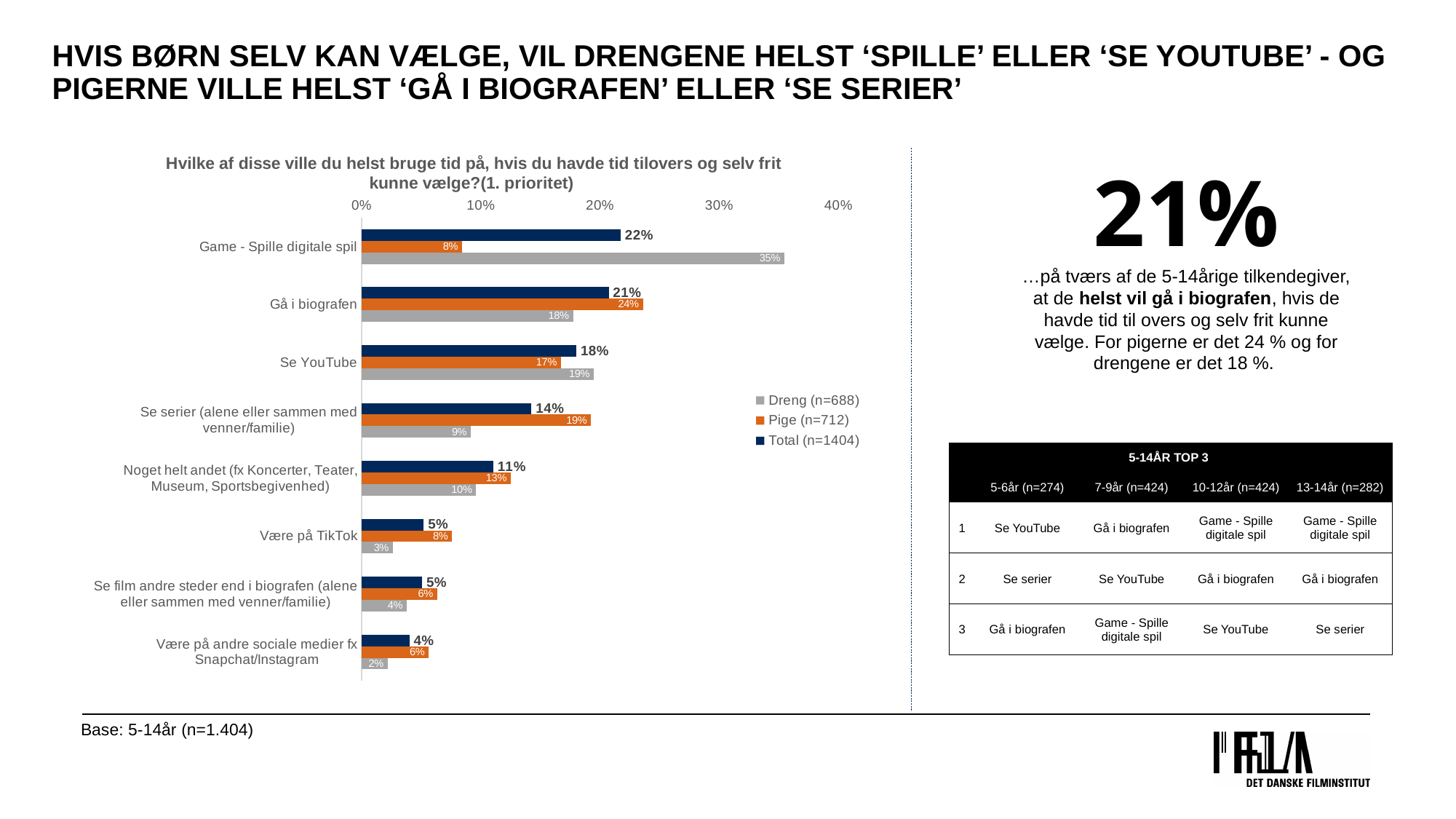
For 'Se serier (alene eller sammen med venner/familie)', which is larger: the Pige (n=712) value or the Dreng (n=688) value? Pige (n=712) What is the Pige (n=712) value for 'Gå i biografen'? 24% How many series does the chart legend list? 3 What is the Dreng (n=688) value for 'Være på TikTok'? 3% Which category has the lowest Total (n=1404) value? Være på andre sociale medier fx Snapchat/Instagram Is the Dreng (n=688) value for 'Game - Spille digitale spil' greater or less than 30%? greater Which category has the highest Dreng (n=688) value? Game - Spille digitale spil What is the Total (n=1404) value for 'Game - Spille digitale spil'? 22% What is the difference between the Dreng (n=688) and Pige (n=712) values for 'Game - Spille digitale spil'? 27% How many categories are shown in the bar chart? 8 What type of chart is shown on the slide? Bar chart What is the Dreng (n=688) value for 'Game - Spille digitale spil'? 35%